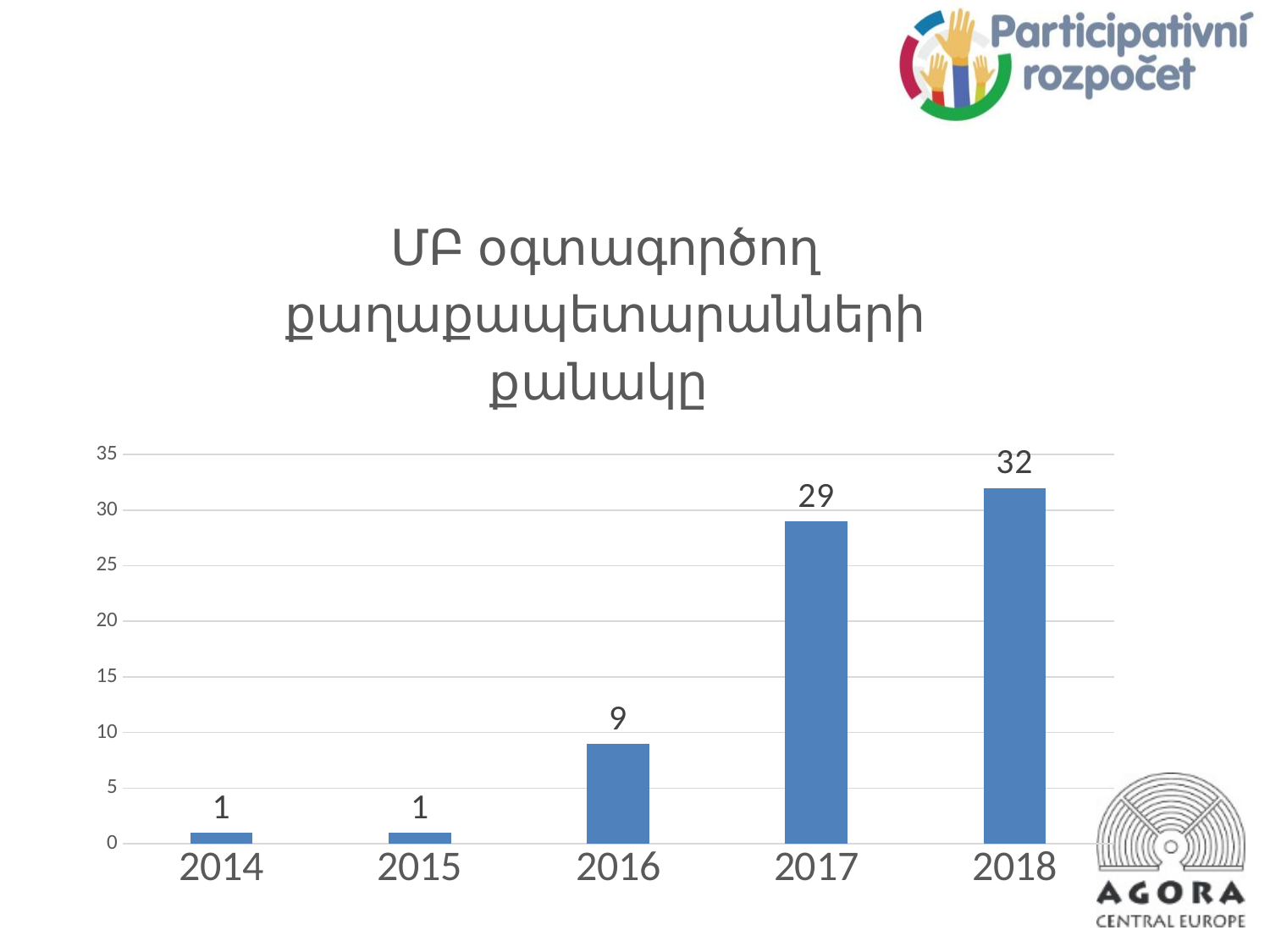
What is the difference between the values for 2018 and 2017? 3 What kind of chart is this? bar chart What is the value for 2017? 29 What is the value for 2018? 32 How many years are shown on the x axis? 5 Do the values rise or fall from 2014 to 2018? rise Which year has the highest value? 2018 What is the difference between the values for 2017 and 2016? 20 Is the value for 2017 greater or less than 25? greater What is the value for 2014? 1 What is the value for 2016? 9 Which is larger, the value for 2016 or the value for 2017? 2017